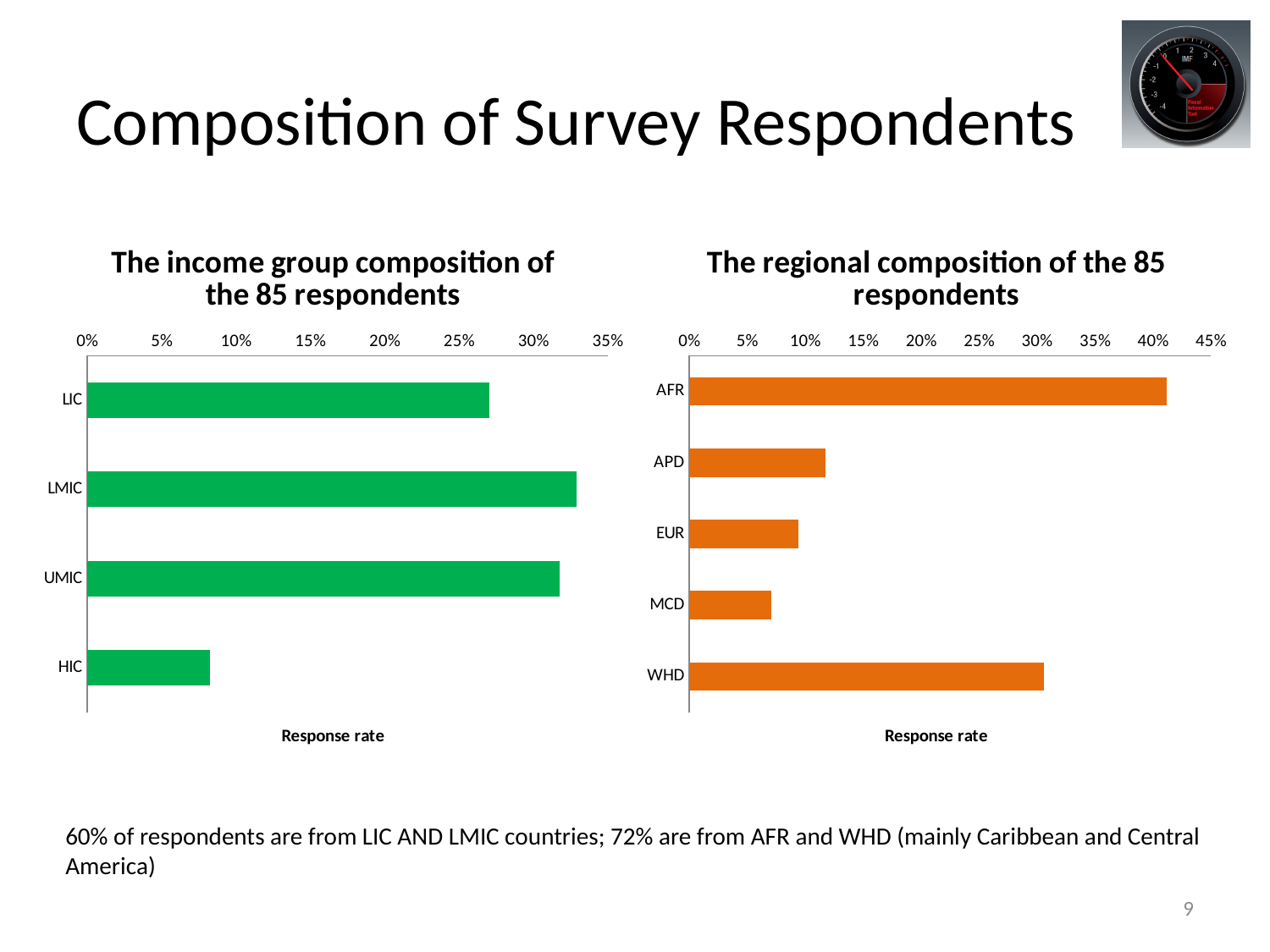
How many income groups are shown in 'The income group composition of the 85 respondents' chart? 4 In 'The income group composition of the 85 respondents' chart, which is larger, the value for LIC or the value for HIC? LIC In 'The income group composition of the 85 respondents' chart, is the value for LIC greater or less than 25%? greater In 'The regional composition of the 85 respondents' chart, which is larger, the value for APD or the value for WHD? WHD What kind of chart is 'The income group composition of the 85 respondents'? bar chart How many regions are shown in 'The regional composition of the 85 respondents' chart? 5 In 'The regional composition of the 85 respondents' chart, which region has the highest response rate? AFR In 'The income group composition of the 85 respondents' chart, which income group has the lowest response rate? HIC In 'The income group composition of the 85 respondents' chart, is the value for HIC greater or less than 10%? less What is the x-axis label of 'The regional composition of the 85 respondents' chart? Response rate In 'The regional composition of the 85 respondents' chart, is the value for WHD greater or less than 25%? greater